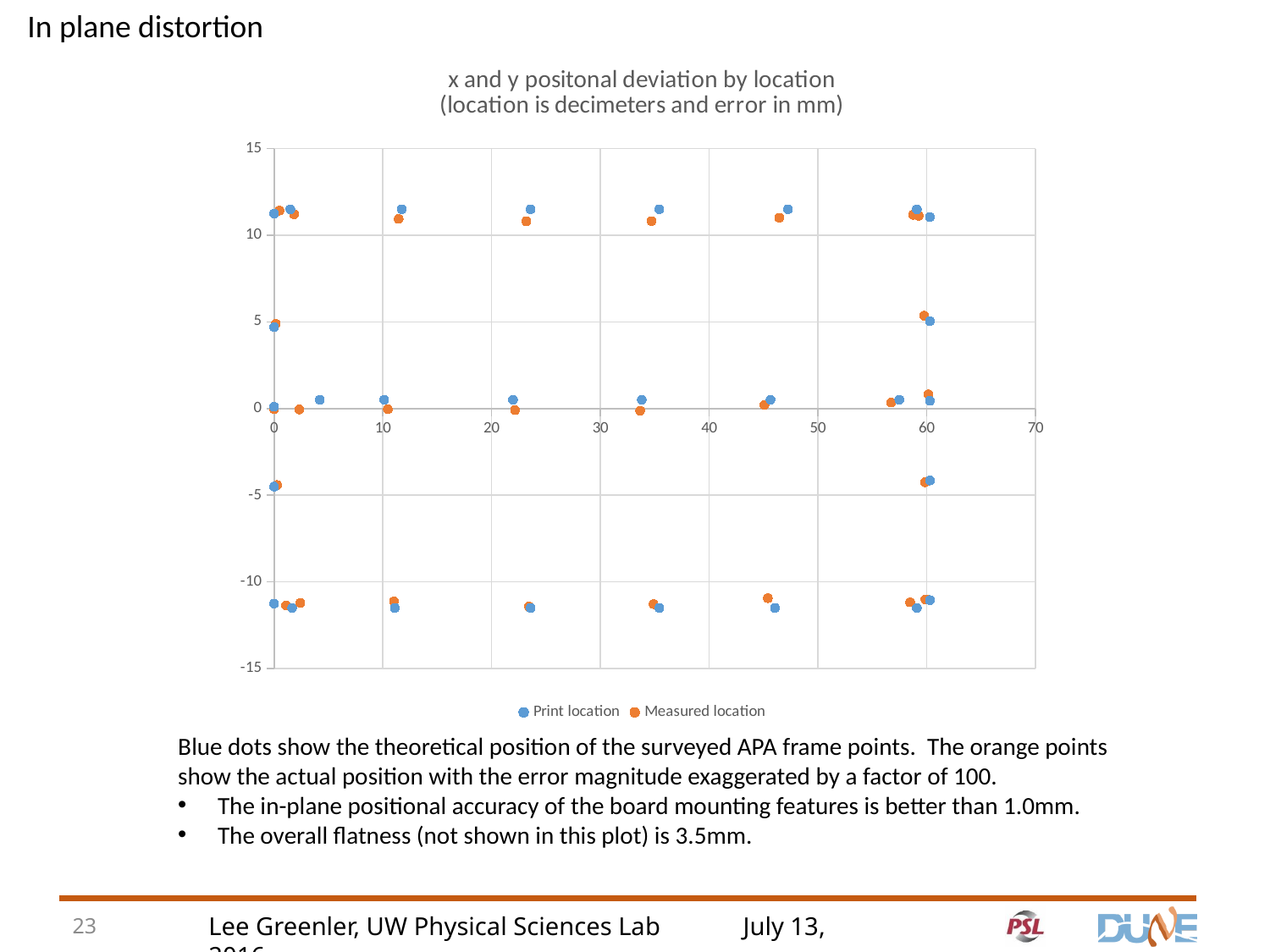
Is the value of the Print location point near x = 0 and y = 5 greater or less than 10? less Which colour represents the Measured location series in the chart? orange Is the value of the Print location point near x = 60 and y = -4 greater or less than 0? less Are the values of the bottom row of points in the chart greater or less than -10? less What is the highest value shown on the chart's vertical axis? 15 What are the two series named in the chart legend? Print location and Measured location What kind of chart is shown on the slide? scatter chart What is the maximum value shown on the chart's horizontal axis? 70 What is the lowest value shown on the chart's vertical axis? -15 How many series does the chart legend list? 2